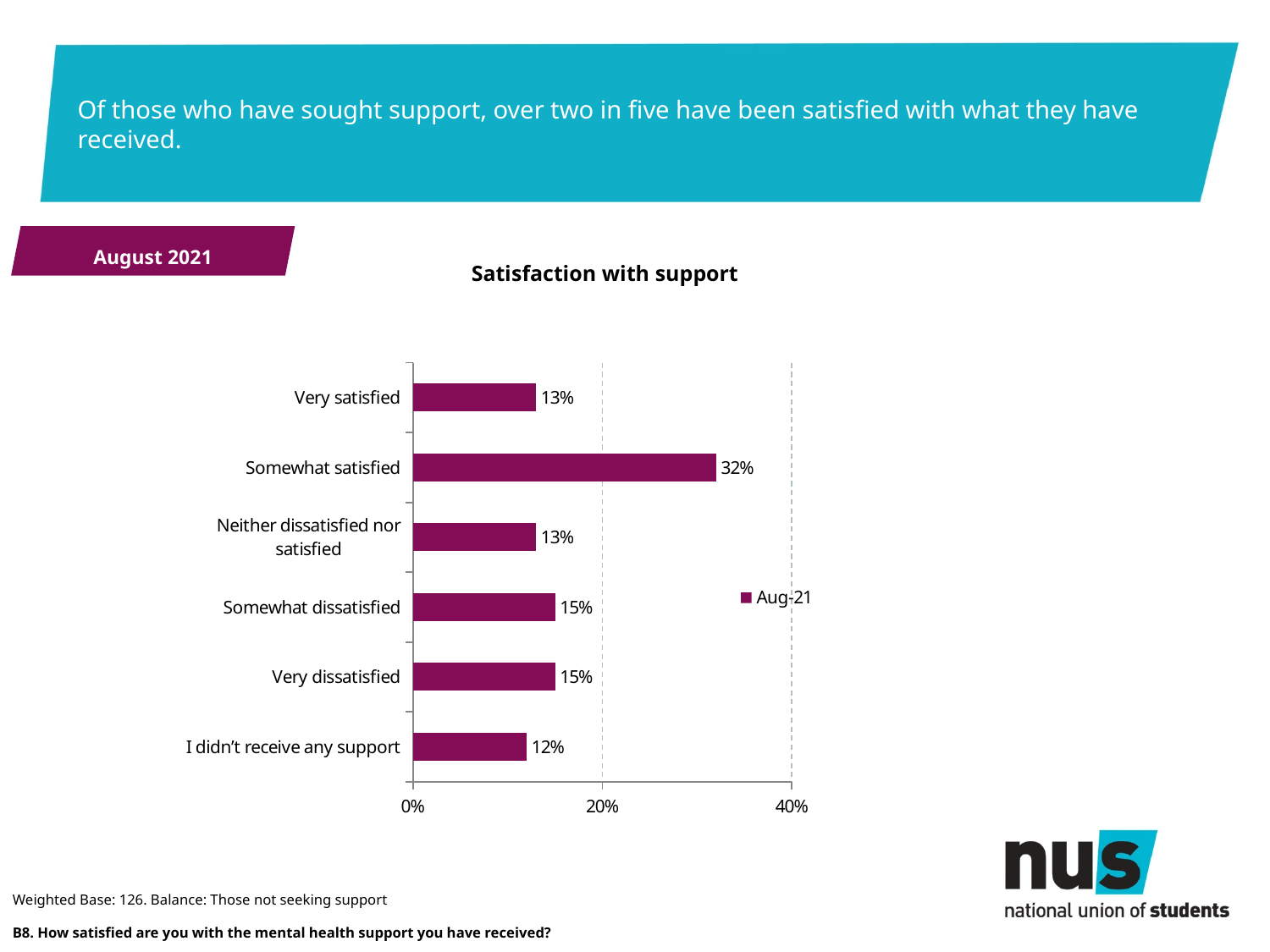
How many series does the legend list? 1 What kind of chart is shown? Bar chart What is the value for I didn't receive any support? 12% What is the value for Somewhat satisfied? 32% What is the value for Very dissatisfied? 15% Which category has the highest value? Somewhat satisfied How many categories are shown in the chart? 6 Is the value for Somewhat satisfied greater or less than 20%? greater What is the title of the chart? Satisfaction with support Which is larger, Somewhat dissatisfied or Very satisfied? Somewhat dissatisfied What is the difference between Somewhat satisfied and Very satisfied? 19% Which category has the lowest value? I didn't receive any support